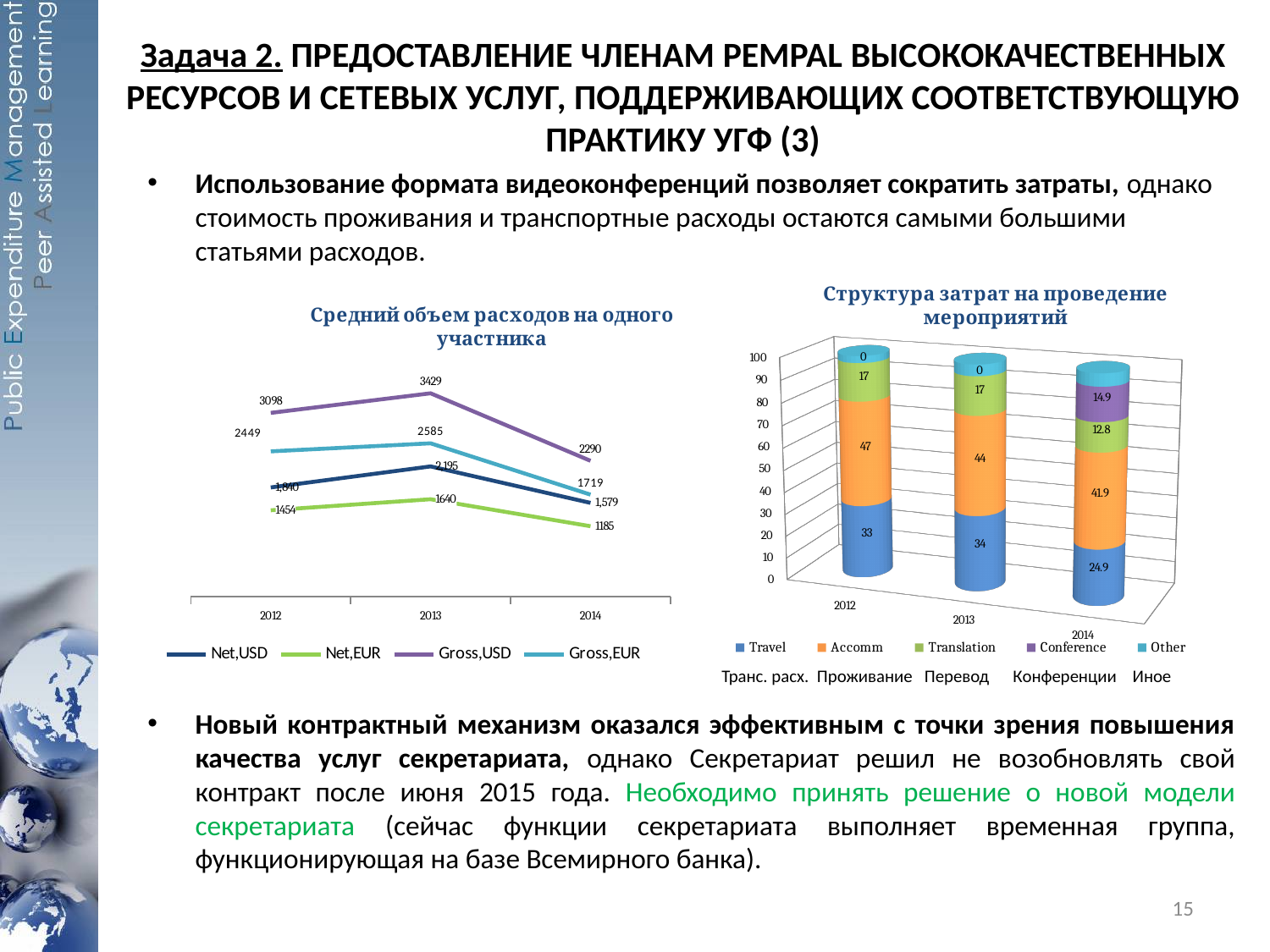
In the chart 'Средний объем расходов на одного участника', which year has the highest Gross,USD value? 2013 In the chart 'Структура затрат на проведение мероприятий', what is the Accomm value for 2012? 47 In the chart 'Средний объем расходов на одного участника', what is the difference between the Gross,USD values for 2013 and 2014? 1139 In the chart 'Структура затрат на проведение мероприятий', which year has the lowest Travel value? 2014 In the chart 'Средний объем расходов на одного участника', what is the Gross,USD value for 2013? 3429 In the chart 'Средний объем расходов на одного участника', how many series does the legend list? 4 What kind of chart is 'Средний объем расходов на одного участника'? line chart In the chart 'Структура затрат на проведение мероприятий', how many series does the legend list? 5 In the chart 'Средний объем расходов на одного участника', does the Gross,EUR value rise or fall from 2013 to 2014? fall In the chart 'Средний объем расходов на одного участника', what is the Net,EUR value for 2014? 1185 In the chart 'Структура затрат на проведение мероприятий', is the Accomm value for 2013 larger than the Travel value for 2013? Yes In the chart 'Структура затрат на проведение мероприятий', what is the Conference value for 2014? 14.9